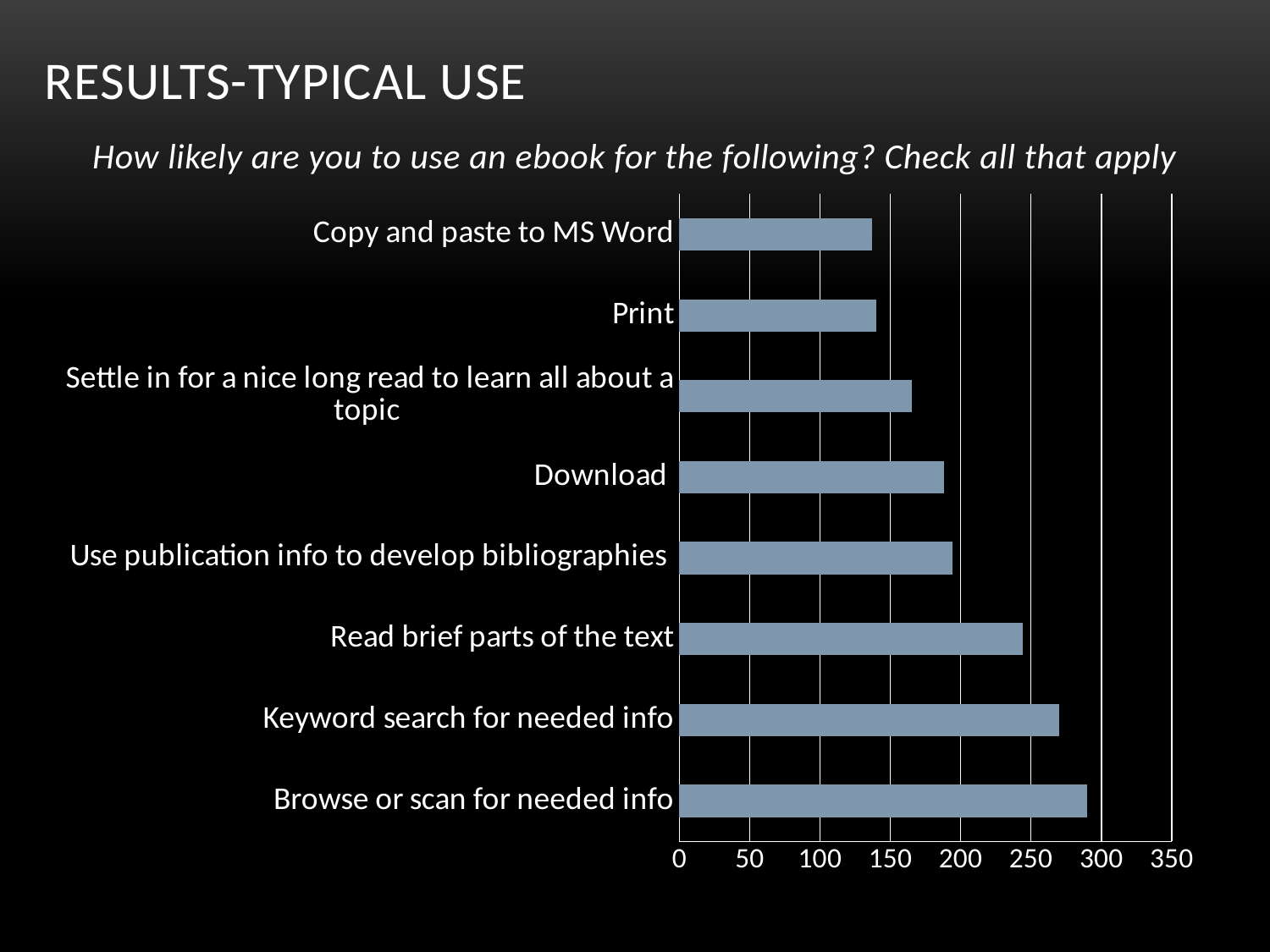
Is the value for Settle in for a nice long read to learn all about a topic greater or less than 150? greater What kind of chart is shown on the slide? bar chart Is the value for Download greater or less than 200? less What is the highest value shown on the horizontal axis of the chart? 350 Is the value for Print greater or less than 150? less How many categories are plotted in the chart? 8 Which is larger, the value for Keyword search for needed info or the value for Read brief parts of the text? Keyword search for needed info Which category has the highest value? Browse or scan for needed info Which is larger, the value for Download or the value for Settle in for a nice long read to learn all about a topic? Download